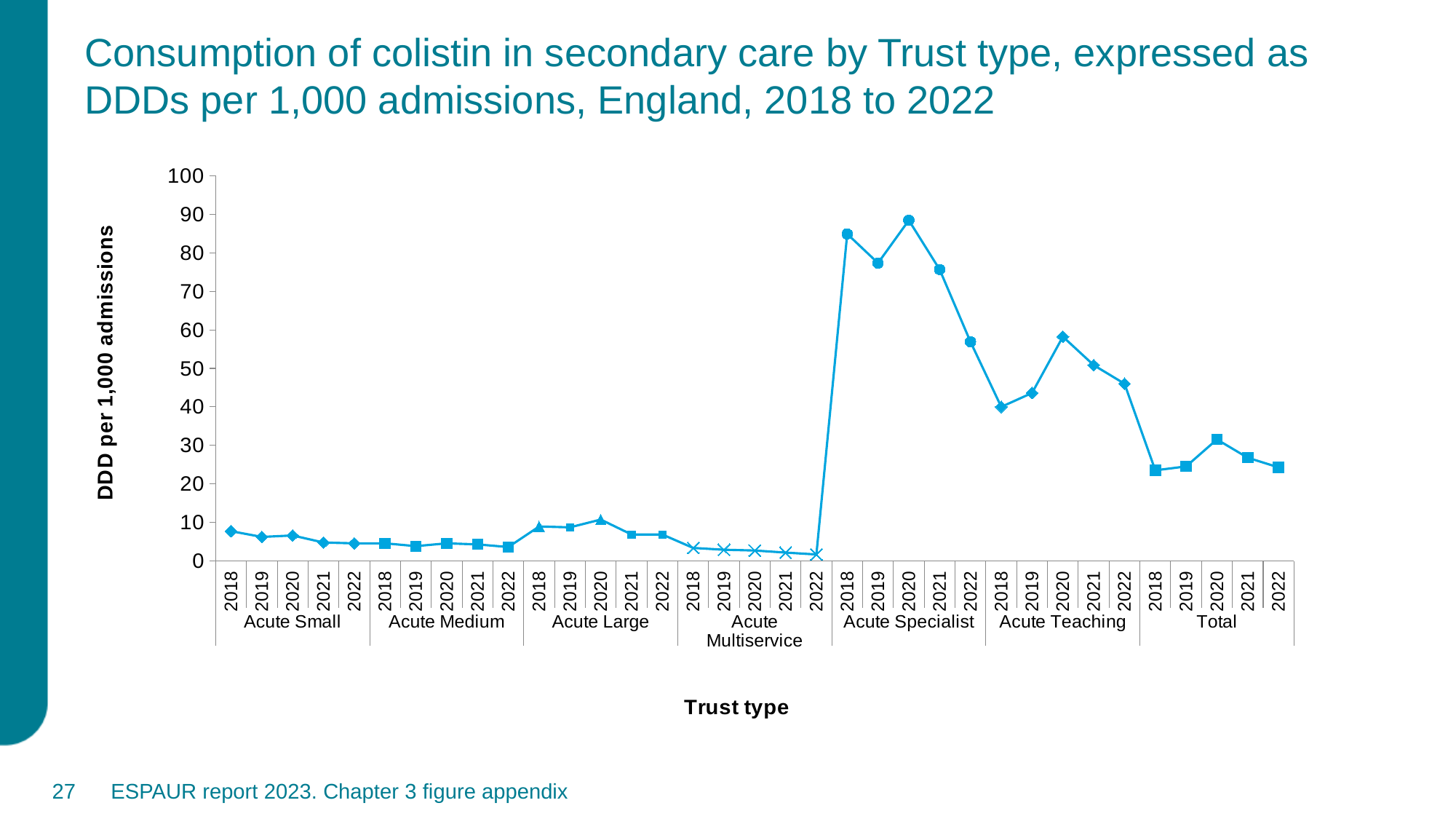
Do the values for Acute Specialist rise or fall from 2020 to 2022? fall Do the values for Acute Multiservice rise or fall from 2018 to 2022? fall How many Trust types are shown along the x axis? 7 How many years are plotted for each Trust type? 5 Is the value for Acute Teaching in 2020 greater or less than 50? greater What kind of chart is shown on the slide? line chart Is the value for Total in 2018 greater or less than 30? less Which Trust type and year has the highest value on the chart? Acute Specialist, 2020 Is the value for Acute Specialist in 2018 greater or less than 80? greater Which is larger, the value for Acute Teaching in 2018 or the value for Total in 2020? Acute Teaching in 2018 Which Trust type and year has the lowest value on the chart? Acute Multiservice, 2022 What is the title of the y axis? DDD per 1,000 admissions